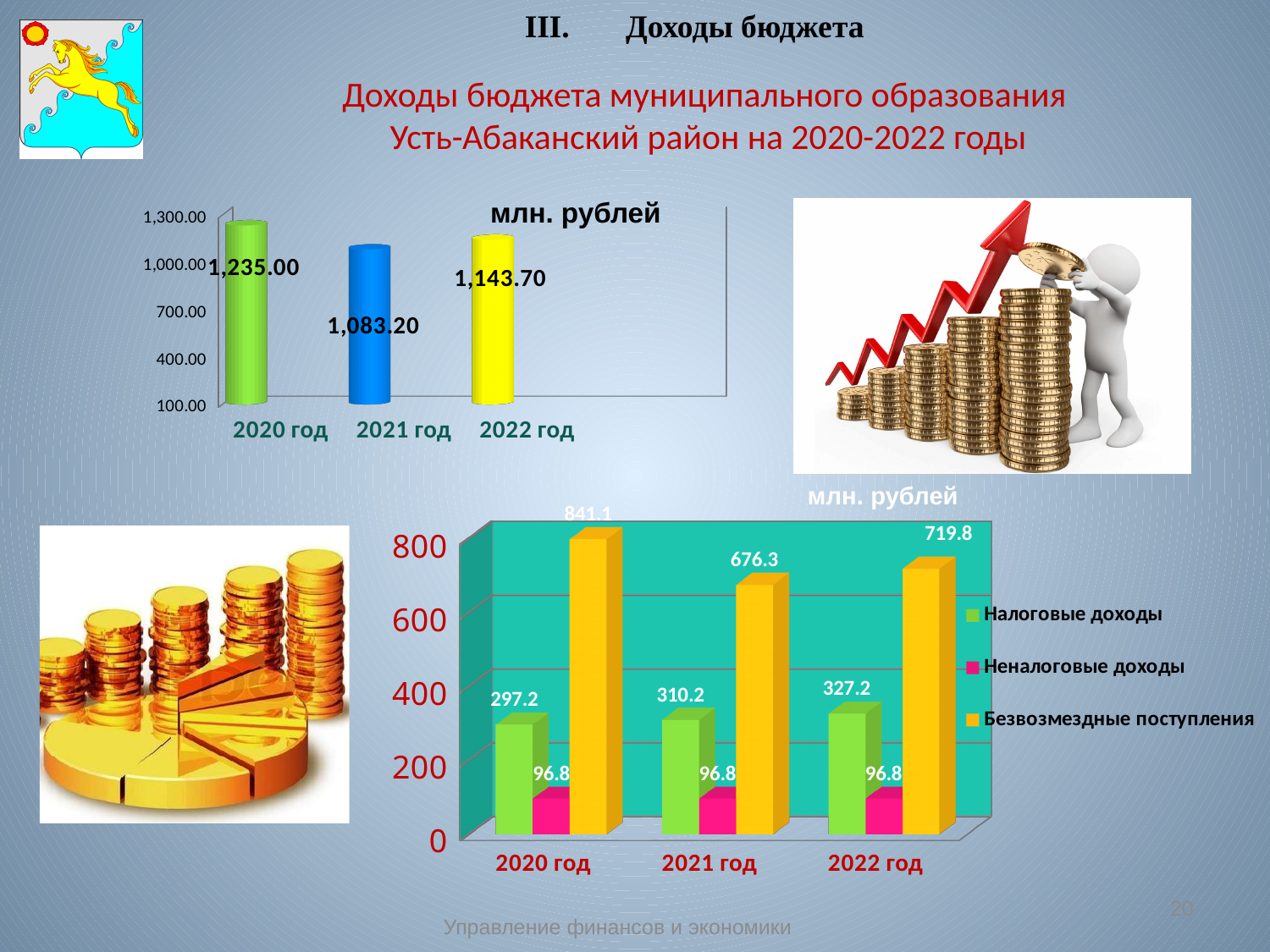
What type of chart is the top-left chart? bar chart In the bottom chart, which is larger for 2022 год: Налоговые доходы or Неналоговые доходы? Налоговые доходы In the bottom chart, what is the value of Налоговые доходы for 2022 год? 327.2 In the top-left chart, what is the value for 2021 год? 1,083.20 How many series does the legend of the bottom chart list? 3 In the top-left chart, which year has the lowest value? 2021 год In the top-left chart, which year has the highest value? 2020 год In the bottom chart, which year has the highest value for Безвозмездные поступления? 2020 год How many bars are in the top-left chart? 3 In the top-left chart, what is the difference between the values for 2020 год and 2022 год? 91.30 In the bottom chart, do the values of Налоговые доходы rise or fall from 2020 год to 2022 год? rise In the bottom chart, what is the value of Безвозмездные поступления for 2021 год? 676.3